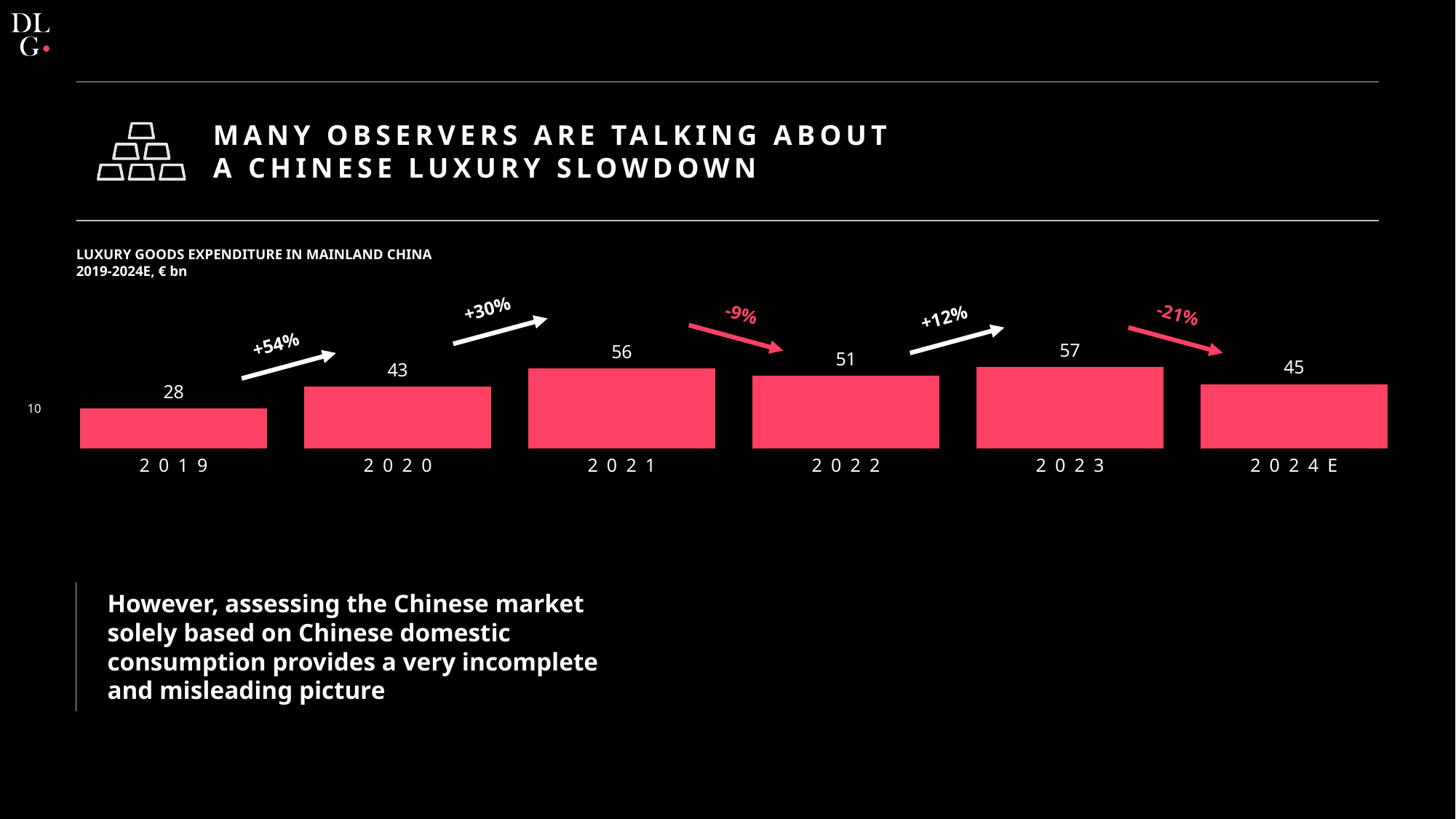
What percentage change is shown between 2023 and 2024E? -21% What unit is the luxury goods expenditure measured in, according to the chart subtitle? € bn What kind of chart is shown on the slide? Bar chart Which is larger, the value for 2021 or the value for 2022? 2021 What is the luxury goods expenditure in mainland China for 2021? 56 What is the difference between the 2023 and 2024E values? 12 Which year has the highest luxury goods expenditure in mainland China? 2023 How many years are shown on the chart? 6 What is the luxury goods expenditure in mainland China for 2019? 28 What is the difference between the 2020 and 2019 values? 15 What is the luxury goods expenditure in mainland China for 2024E? 45 Which year has the lowest luxury goods expenditure in mainland China? 2019